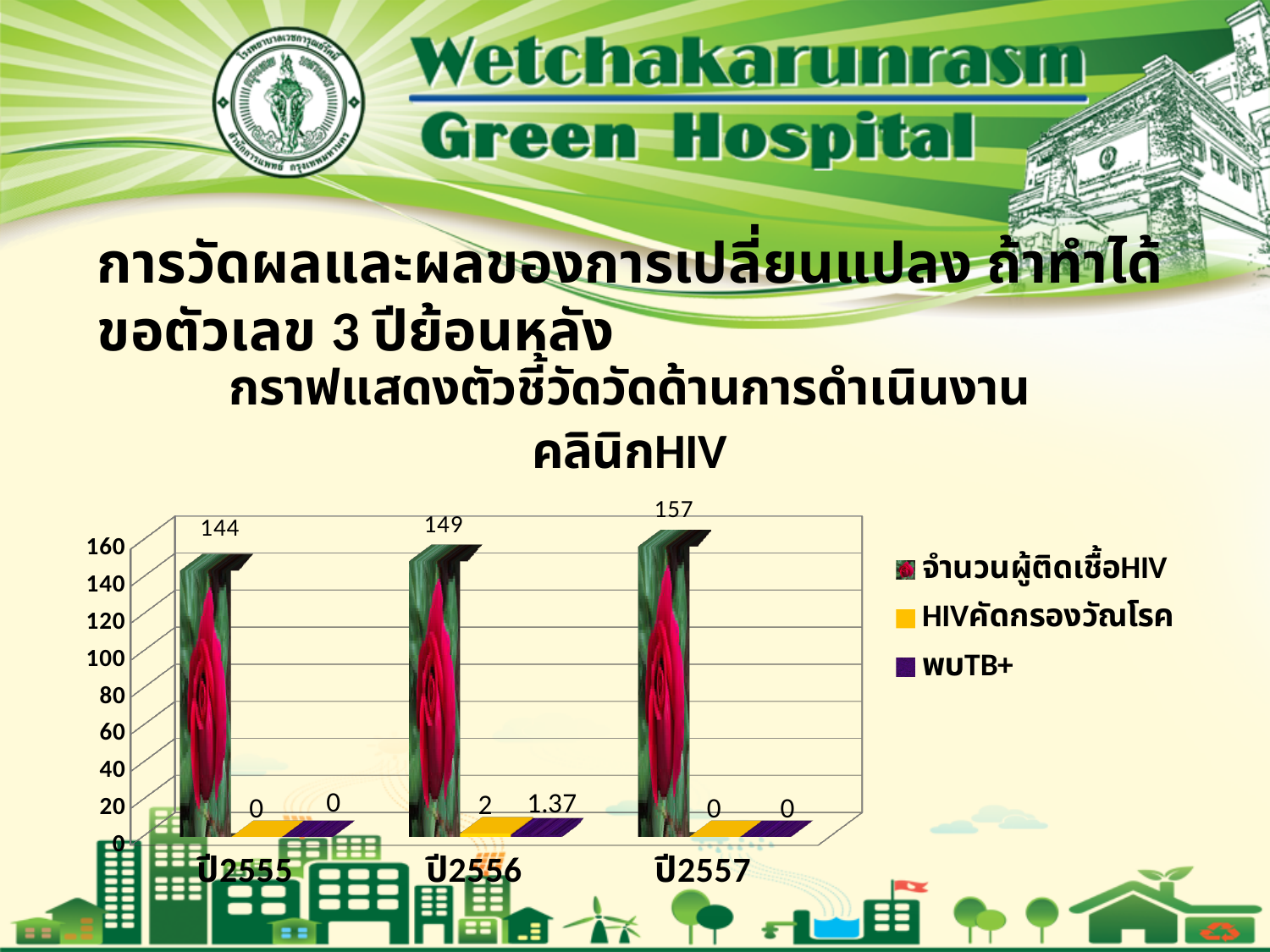
What is the value of จำนวนผู้ติดเชื้อHIV for ปี2555? 144 In which year is จำนวนผู้ติดเชื้อHIV lowest? ปี2555 How many years (categories) are shown on the x axis? 3 In which year is จำนวนผู้ติดเชื้อHIV highest? ปี2557 Which is larger: จำนวนผู้ติดเชื้อHIV in ปี2556 or in ปี2555? ปี2556 What is the value of HIVคัดกรองวัณโรค for ปี2556? 2 How many series does the legend list? 3 What is the value of จำนวนผู้ติดเชื้อHIV for ปี2557? 157 What is the difference in จำนวนผู้ติดเชื้อHIV between ปี2557 and ปี2555? 13 What is the value of พบTB+ for ปี2556? 1.37 Does จำนวนผู้ติดเชื้อHIV rise or fall from ปี2555 to ปี2557? rise What kind of chart is shown on the slide? bar chart